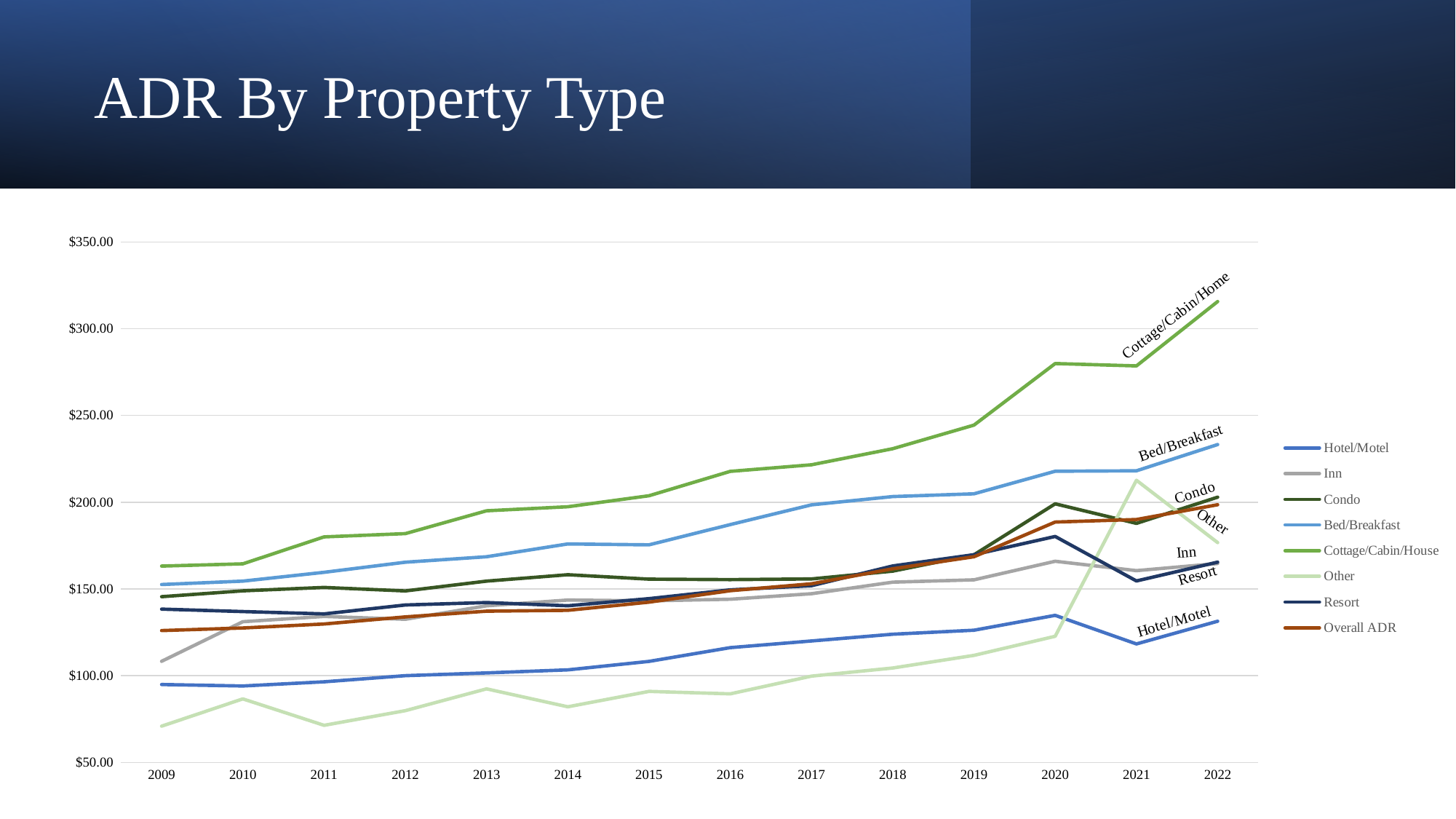
Is the value for Other in 2021 greater or less than $200.00? greater How many series does the legend list? 8 Is the value for Bed/Breakfast in 2022 greater or less than $250.00? less Which property type has the lowest ADR in 2022? Hotel/Motel Does the Cottage/Cabin/House line generally rise or fall from 2009 to 2022? Rise In 2020, which is larger: the ADR for Condo or the ADR for Resort? Condo Which property type has the highest ADR in 2022? Cottage/Cabin/House Which property type has the lowest ADR in 2009? Other How many years are plotted along the x axis? 14 What kind of chart is shown on the slide? Line chart Is the value for Hotel/Motel in 2009 greater or less than $100.00? less